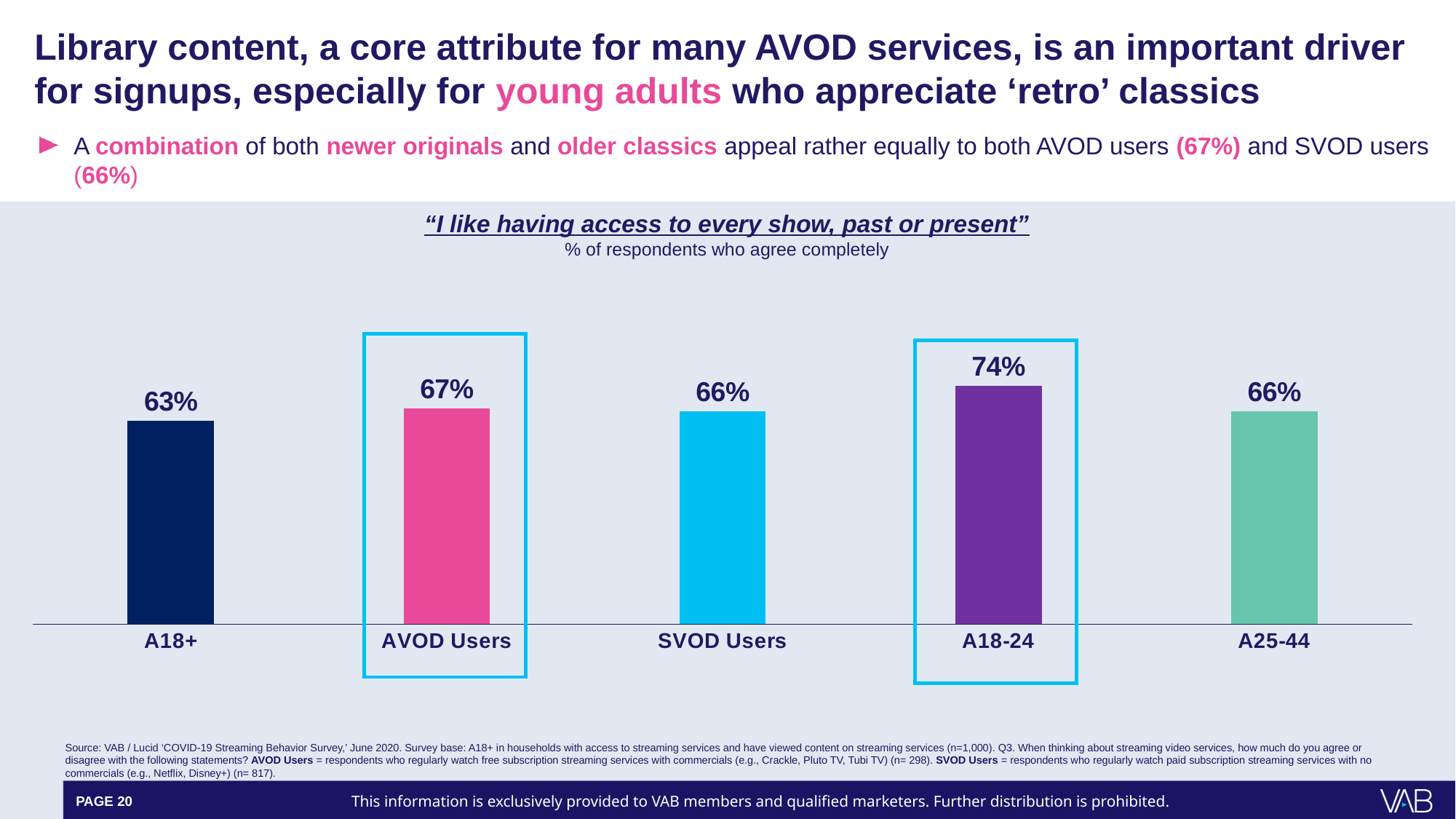
How many categories are shown in the chart? 5 Which category has the lowest percentage of respondents who agree completely? A18+ What is the difference in percentage points between AVOD Users and SVOD Users? 1 Which category has the highest percentage of respondents who agree completely? A18-24 Which is larger, the value for A18-24 or the value for A25-44? A18-24 What is the value shown for AVOD Users? 67% What percentage of A18+ respondents agree completely with "I like having access to every show, past or present"? 63% What is the value shown for A18-24? 74% What is the difference in percentage points between A18-24 and A18+? 11 What type of chart is shown on the slide? Bar chart What is the value shown for SVOD Users? 66% What is the value shown for A25-44? 66%